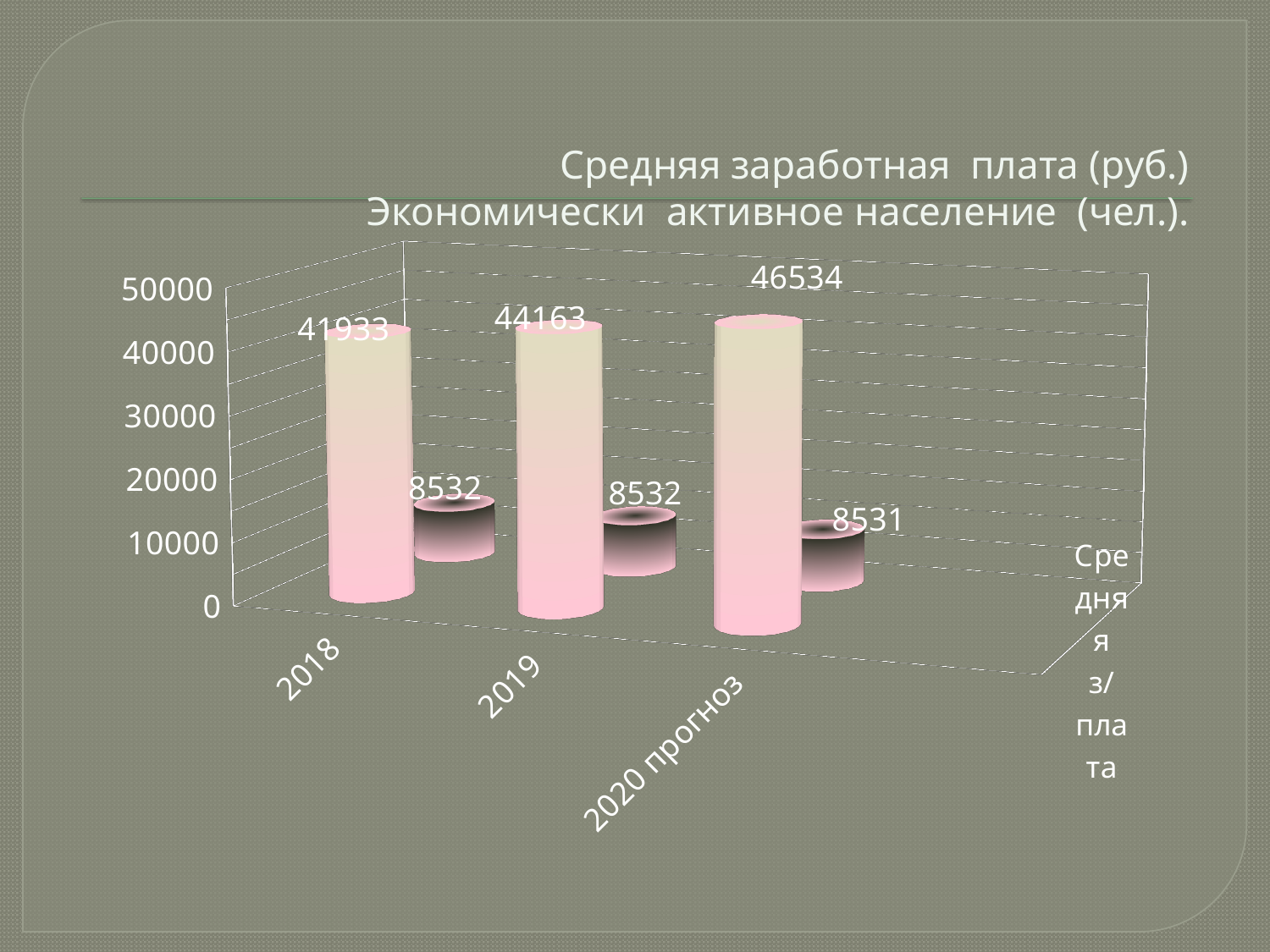
Is the average salary value for 2019 greater or less than 40000? greater What is the average salary value shown for 2020 прогноз? 46534 What is the average salary (Средняя заработная плата) value shown for 2018? 41933 Do the average salary values rise or fall from 2018 to 2020 прогноз? rise How many categories are shown on the x axis of the chart? 3 What is the economically active population value shown for 2018? 8532 Which year has the highest average salary value? 2020 прогноз Which year has the lowest average salary value? 2018 What is the average salary value shown for 2019? 44163 What is the difference between the average salary values for 2020 прогноз and 2018? 4601 What is the economically active population (Экономически активное население) value shown for 2020 прогноз? 8531 What is the difference between the average salary values for 2019 and 2018? 2230